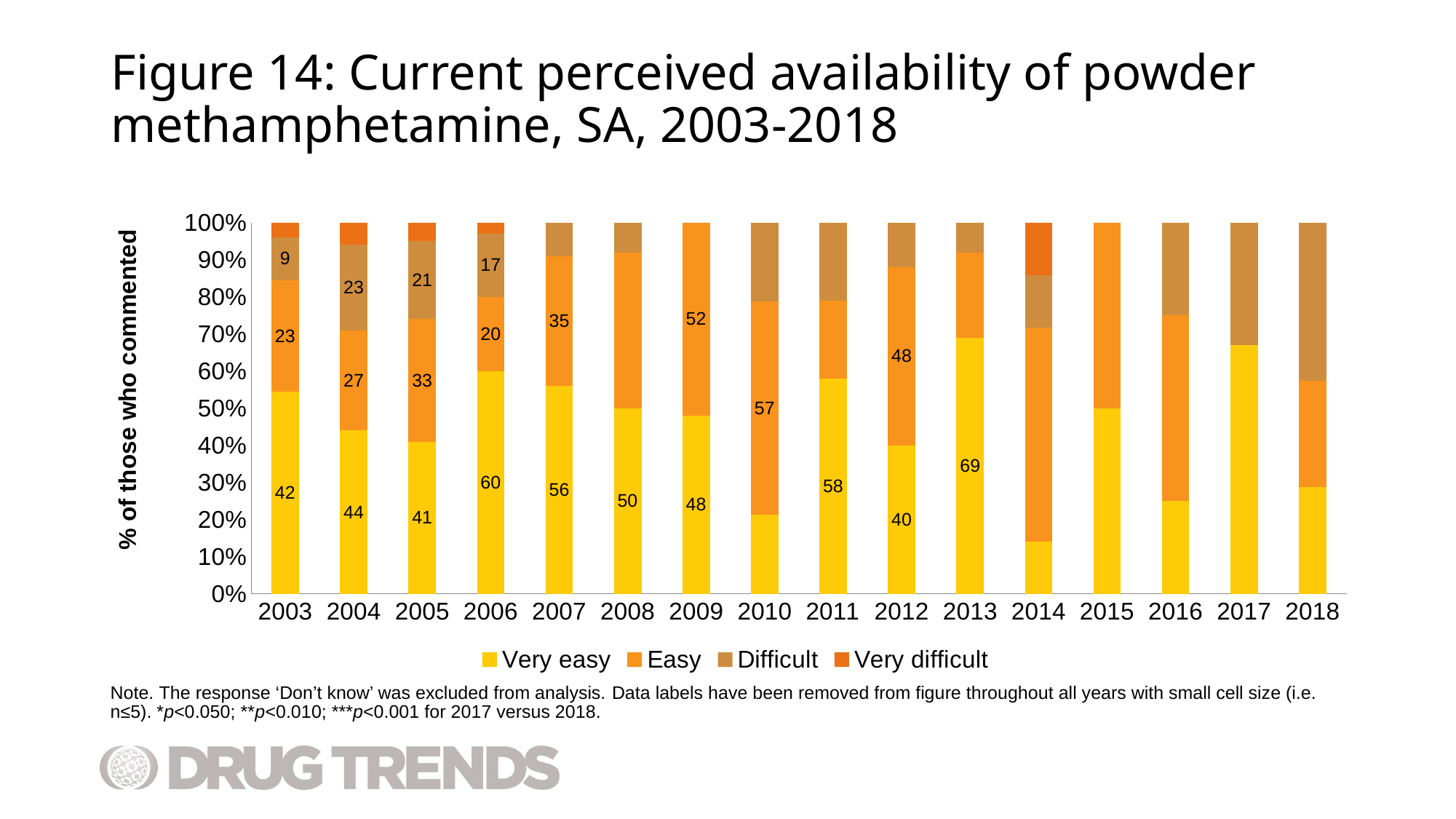
How many years are shown on the x axis? 16 Which year has the smallest 'Very easy' segment? 2014 What kind of chart is shown on the slide? Stacked bar chart What is the difference between the 'Easy' values for 2009 and 2007? 17 Is the 'Very easy' value for 2014 greater or less than 20%? less Is the 'Very easy' value for 2017 greater or less than 60%? greater What is the data label for the 'Very easy' segment in 2013? 69 What is the data label for the 'Difficult' segment in 2004? 23 What is the data label for the 'Difficult' segment in 2006? 17 How many series does the legend list? 4 Which year has the larger 'Very easy' value, 2006 or 2007? 2006 What is the data label for the 'Easy' segment in 2010? 57